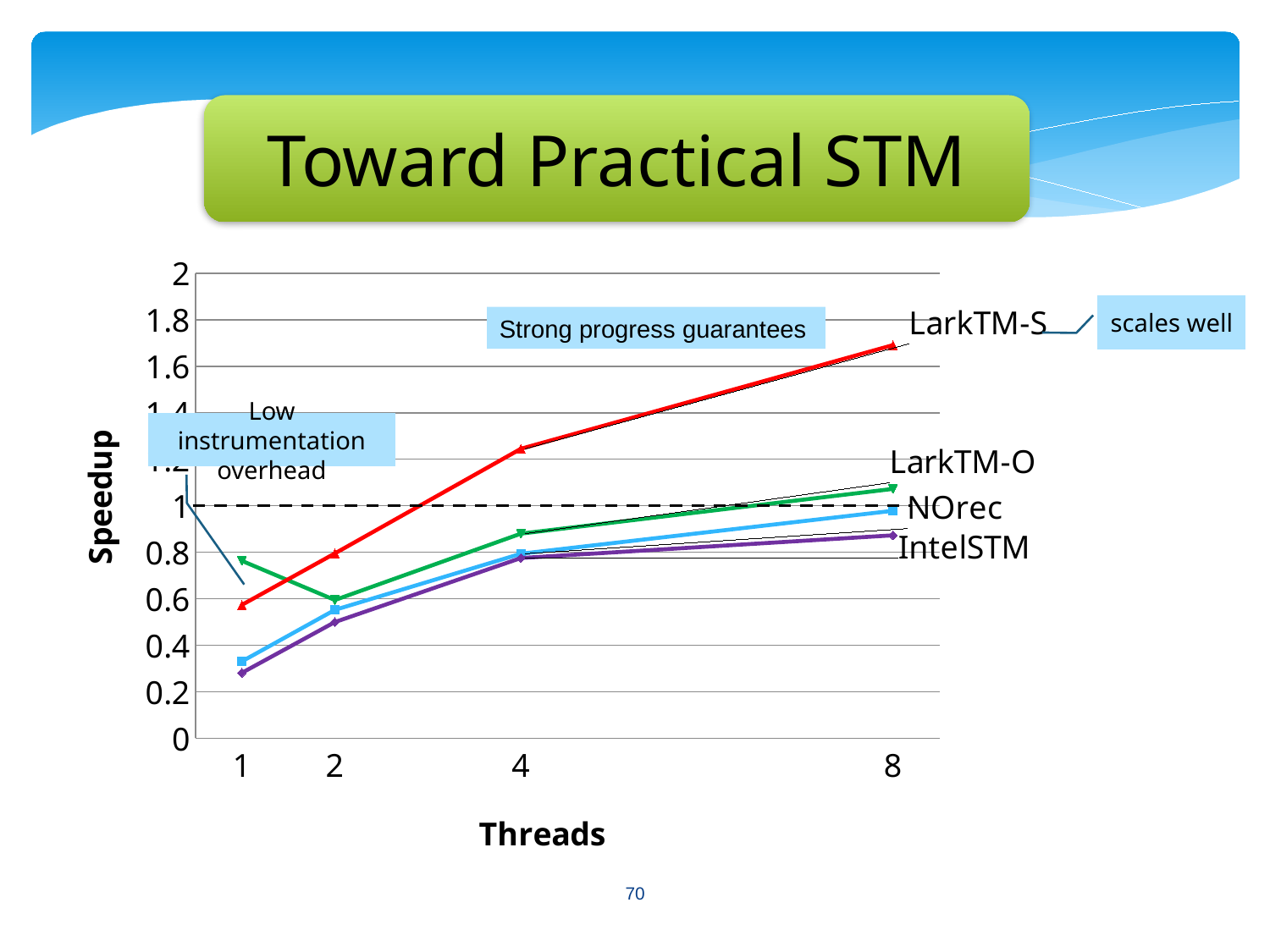
Does the speedup for LarkTM-S rise or fall as the number of threads increases? rise Is the speedup for IntelSTM at 8 threads greater or less than 1? less How many series are plotted on the chart? 4 What is the label of the y axis? Speedup Which series has the highest speedup at 8 threads? LarkTM-S Is the speedup for IntelSTM at 1 thread greater or less than 0.4? less How many thread counts are shown on the x axis? 4 What kind of chart is shown on the slide? line chart Is the speedup for LarkTM-S at 8 threads greater or less than 1.6? greater Which series has the highest speedup at 1 thread? LarkTM-O Which series has the lowest speedup at 8 threads? IntelSTM Which is larger at 4 threads, the speedup for LarkTM-S or for NOrec? LarkTM-S